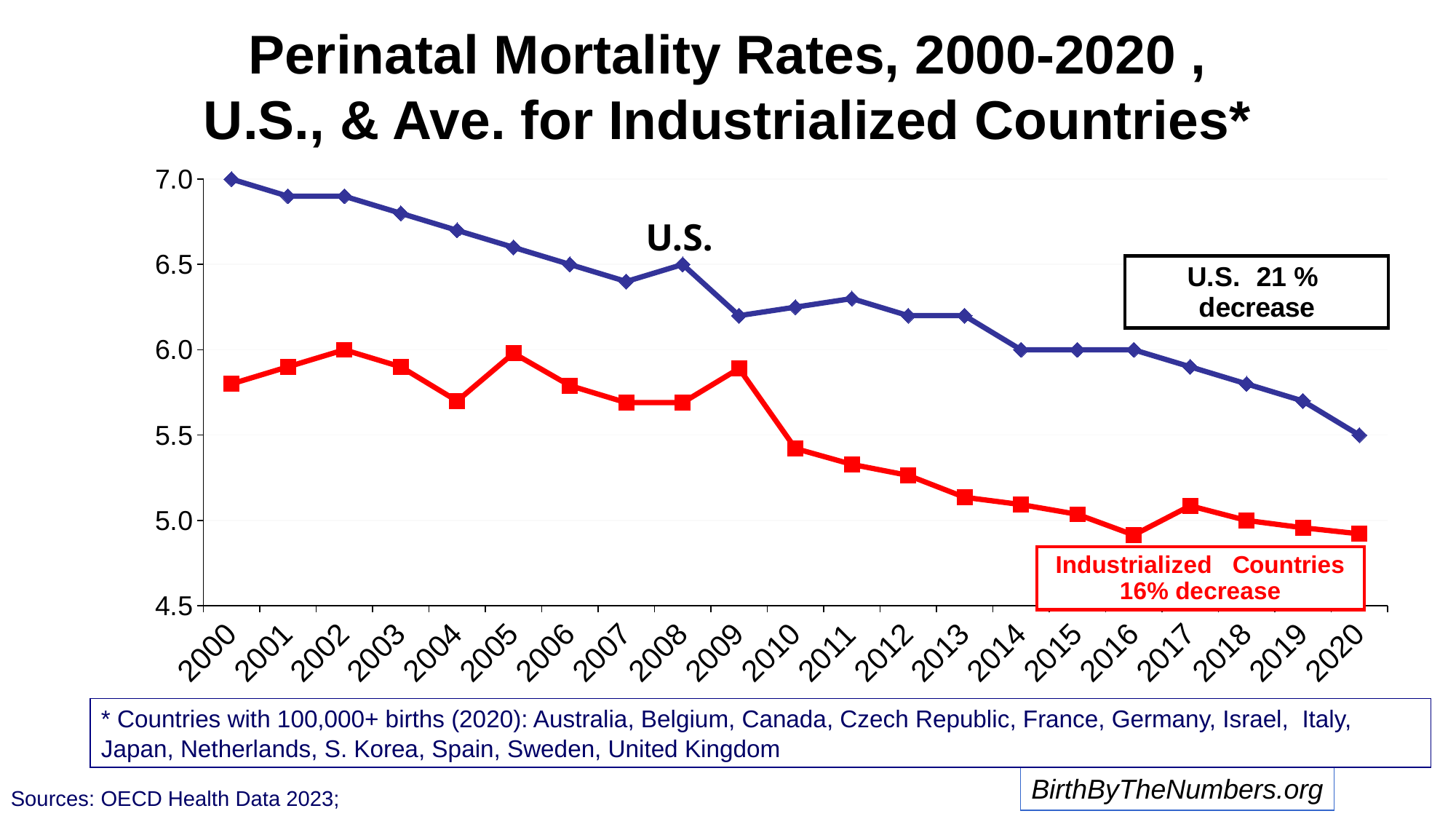
What is the U.S. perinatal mortality rate in 2015? 6.0 Is the U.S. value for 2011 greater or less than 6.0? greater Is the Industrialized Countries value for 2010 greater or less than 5.5? less How many data series are plotted on the chart? 2 What is the U.S. perinatal mortality rate in 2000? 7.0 Which series has the higher value in 2009, U.S. or Industrialized Countries? U.S. What percentage decrease does the slide report for the Industrialized Countries series? 16% decrease What kind of chart is shown on the slide? line chart What is the U.S. perinatal mortality rate in 2020? 5.5 Is the Industrialized Countries value for 2005 greater or less than 5.5? greater How many years are plotted along the x axis? 21 Does the U.S. series generally rise or fall from 2000 to 2020? fall